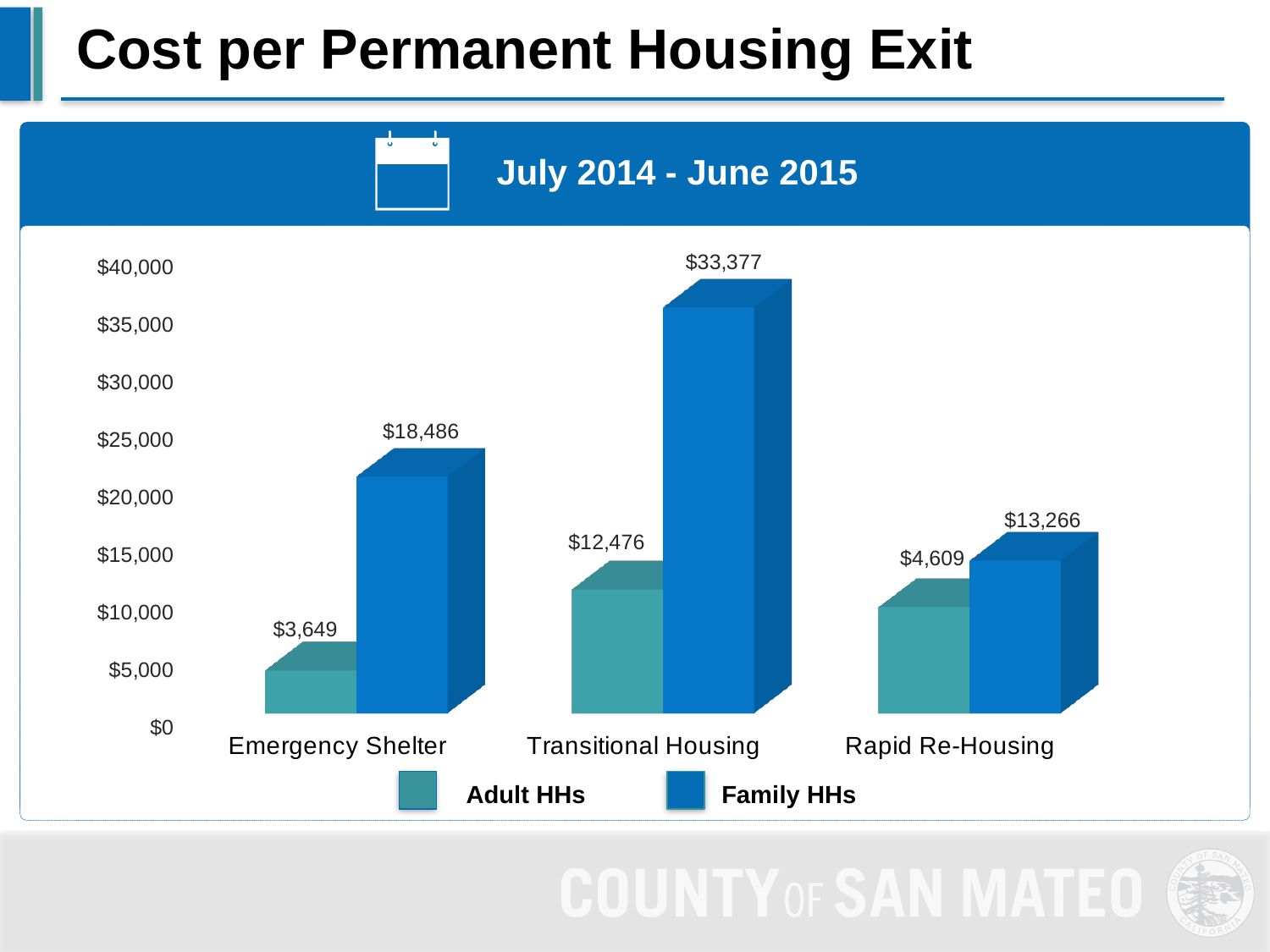
What is the difference between the Family HHs and Adult HHs cost per permanent housing exit in Transitional Housing? $20,901 Which is larger: the Adult HHs cost in Transitional Housing or the Family HHs cost in Rapid Re-Housing? Family HHs cost in Rapid Re-Housing What is the cost per permanent housing exit for Adult HHs in Emergency Shelter? $3,649 What is the cost per permanent housing exit for Family HHs in Emergency Shelter? $18,486 What is the difference between the Family HHs and Adult HHs cost per permanent housing exit in Rapid Re-Housing? $8,657 How many program types are shown on the x axis? 3 What is the cost per permanent housing exit for Adult HHs in Rapid Re-Housing? $4,609 What is the cost per permanent housing exit for Family HHs in Transitional Housing? $33,377 Which program type has the highest cost per permanent housing exit for Family HHs? Transitional Housing How many series does the legend list? 2 Which program type has the lowest cost per permanent housing exit for Adult HHs? Emergency Shelter What kind of chart is shown on the slide? Bar chart